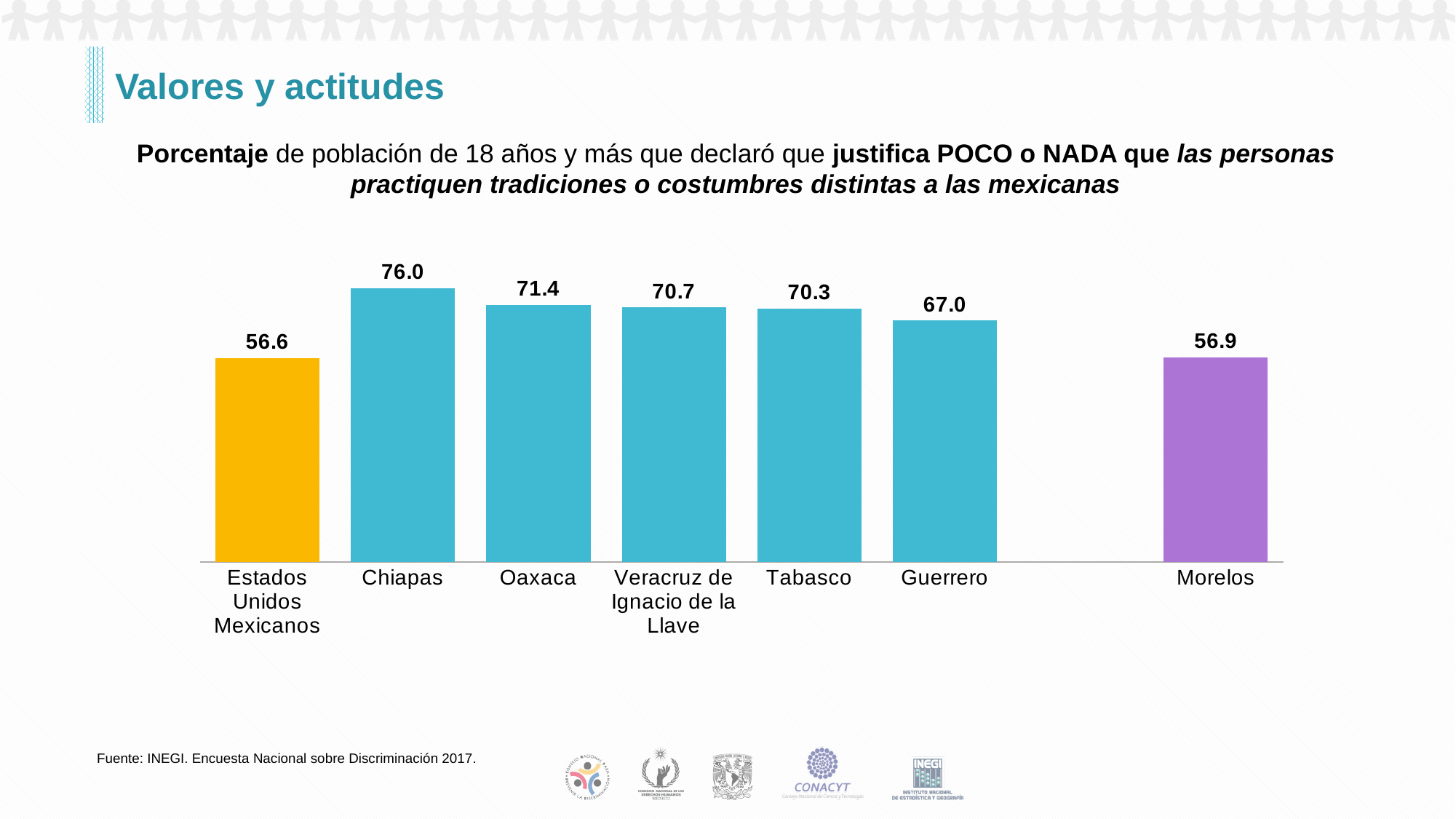
What kind of chart is shown on the slide? Bar chart Which category has the highest value? Chiapas What is the value for Chiapas? 76.0 What colour is the bar for Morelos? Purple What is the difference between the values for Chiapas and Guerrero? 9.0 What is the value for Veracruz de Ignacio de la Llave? 70.7 Which category has the lowest value? Estados Unidos Mexicanos Which is larger, the value for Oaxaca or the value for Guerrero? Oaxaca How many categories are shown in the chart? 7 What is the difference between the values for Oaxaca and Tabasco? 1.1 What is the value for Morelos? 56.9 What is the value for Estados Unidos Mexicanos? 56.6